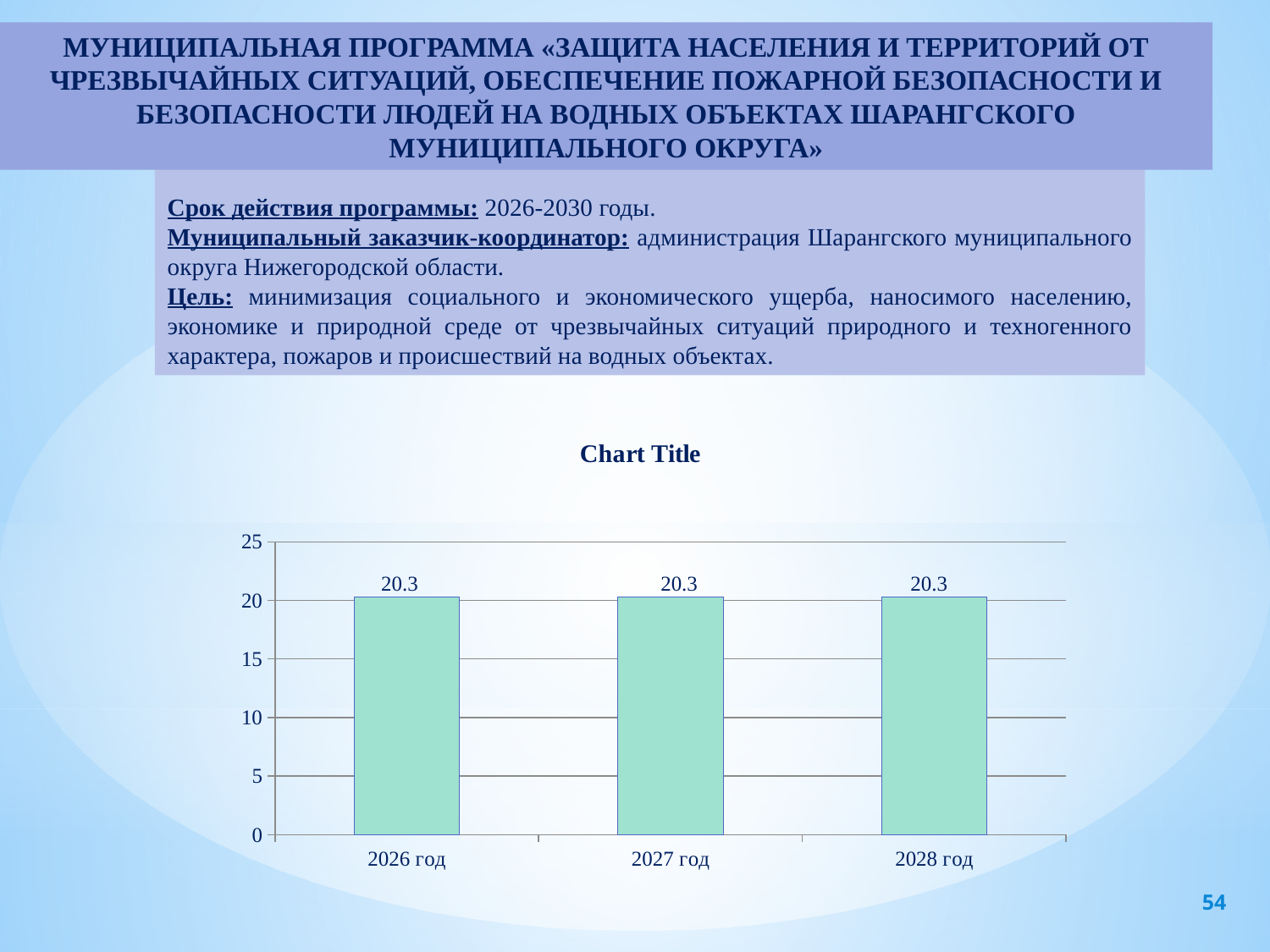
Do the values rise, fall or stay the same from 2026 год to 2028 год? stay the same What is the value for 2026 год? 20.3 What is the value for 2028 год? 20.3 What is the value for 2027 год? 20.3 Is the value for 2027 год greater or less than 20? greater How many categories are shown on the x axis? 3 Is the value for 2026 год greater or less than 25? less What is the title of the chart? Chart Title What is the highest value shown on the vertical axis? 25 What kind of chart is shown on the slide? bar chart What is the difference between the values for 2026 год and 2028 год? 0